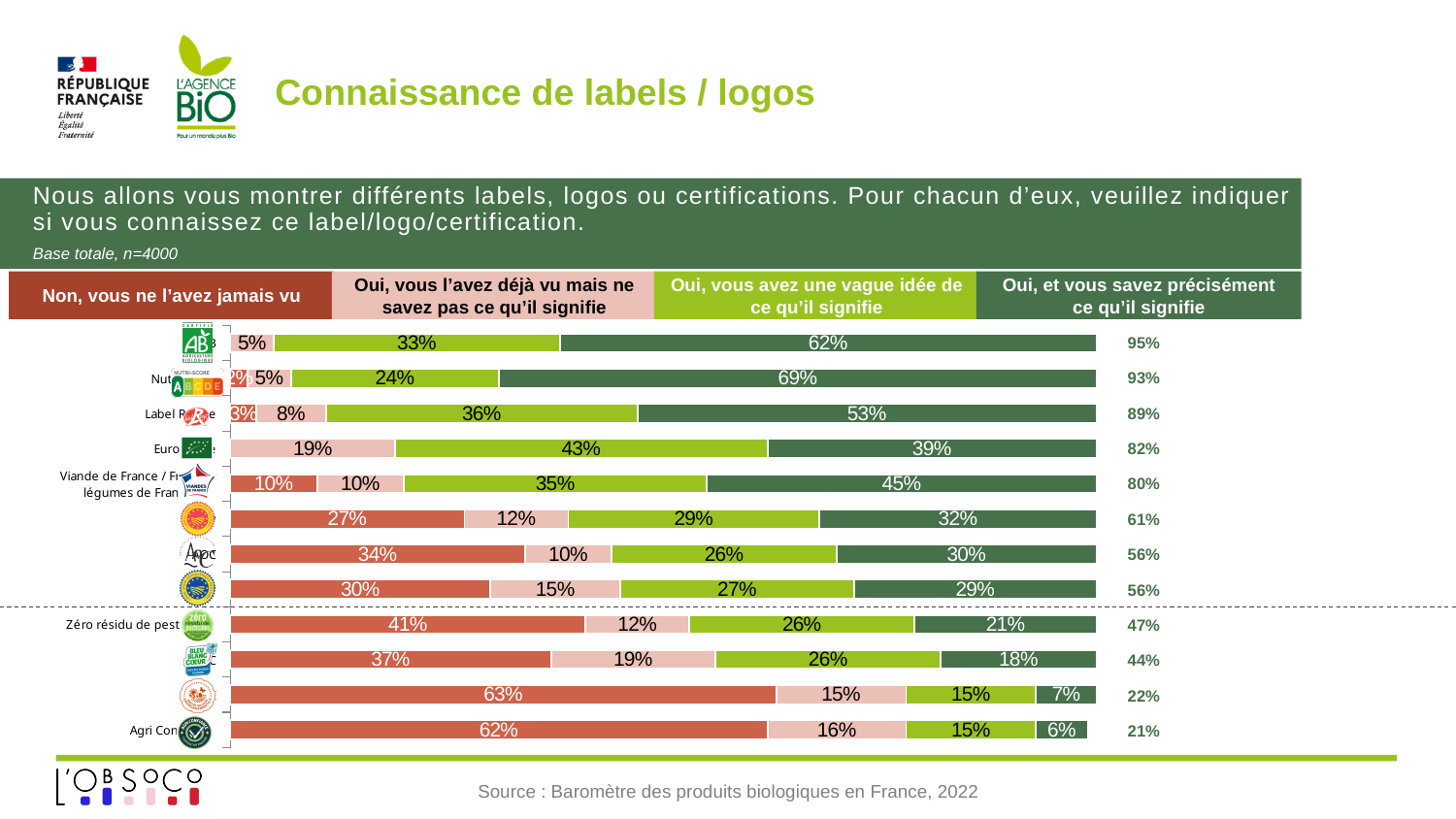
What is the total shown at the right of the bar for Label Rouge? 89% What kind of chart is shown on the slide? Stacked bar chart What percentage of respondents say they know precisely what the AB label means ("Oui, et vous savez précisément ce qu'il signifie")? 62% How many labels/logos (rows) are plotted in the chart? 12 Which has a larger "Oui, et vous savez précisément ce qu'il signifie" value: Nutri-Score or Label Rouge? Nutri-Score What percentage of respondents have never seen the Agri Confiance logo ("Non, vous ne l'avez jamais vu")? 62% How many series does the legend list? 4 For the Viande de France / Fruits et légumes de France row, what percentage have a vague idea of what it means ("Oui, vous avez une vague idée de ce qu'il signifie")? 35% Which label/logo has the highest total percentage shown at the right of the chart? AB What is the source cited at the bottom of the slide? Baromètre des produits biologiques en France, 2022 Which label/logo has the lowest total percentage shown at the right of the chart? Agri Confiance